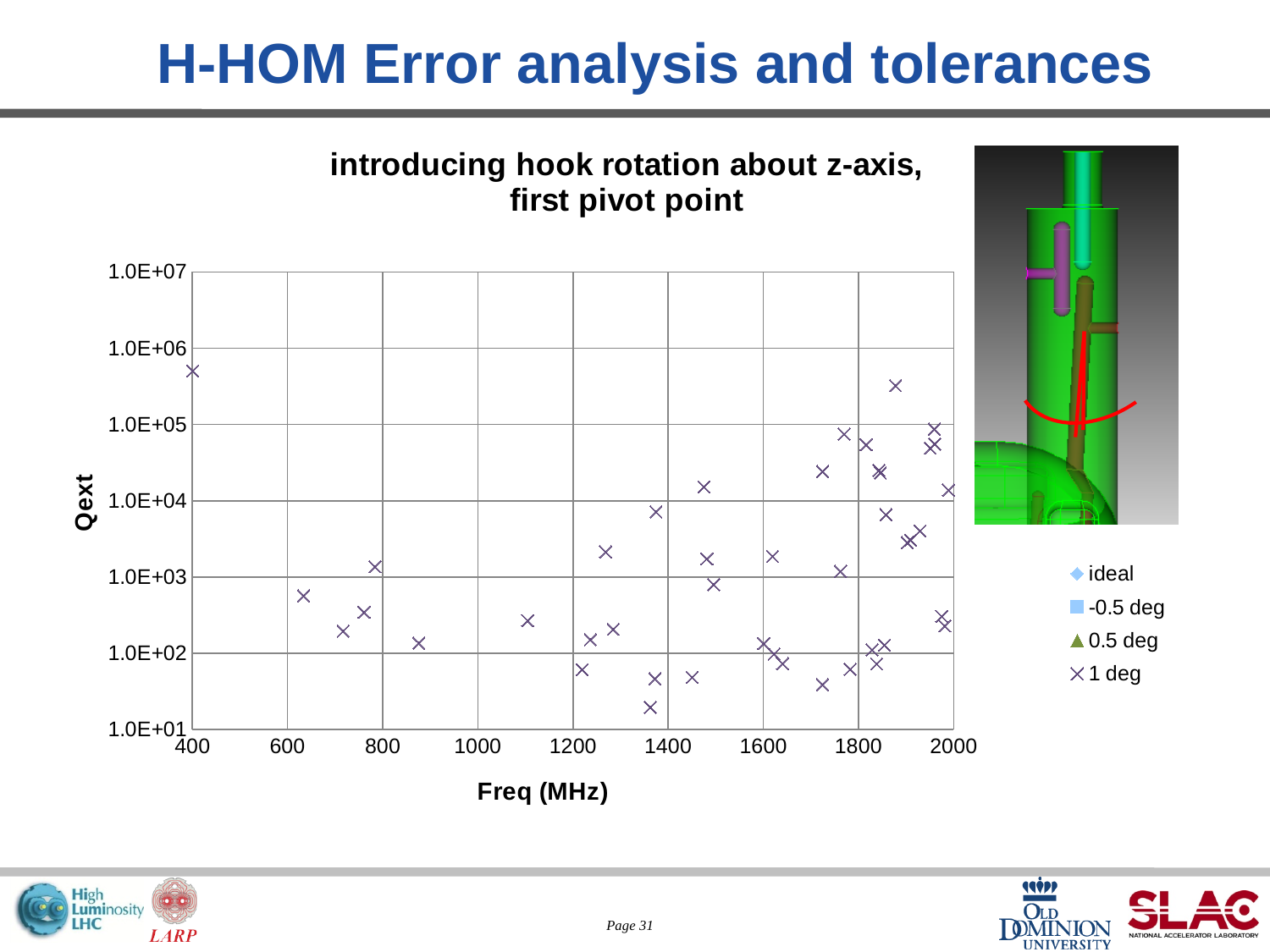
Which has the larger Qext value: the point near 1480 MHz at the top of its cluster or the point near 1100 MHz? the point near 1480 MHz Is the Qext value of the lowest point on the chart (near 1360 MHz) greater or less than 1.0E+02? less Is the Qext value of the point near 1100 MHz greater or less than 1.0E+03? less Is the Qext value of the point near 880 MHz greater or less than 1.0E+03? less What kind of chart is shown on the slide? scatter chart How many series does the chart legend list? 4 What is the title of the chart? introducing hook rotation about z-axis, first pivot point Which has the larger Qext value: the point near 400 MHz or the point near 630 MHz? the point near 400 MHz Which legend entry is plotted with x-shaped markers? 1 deg